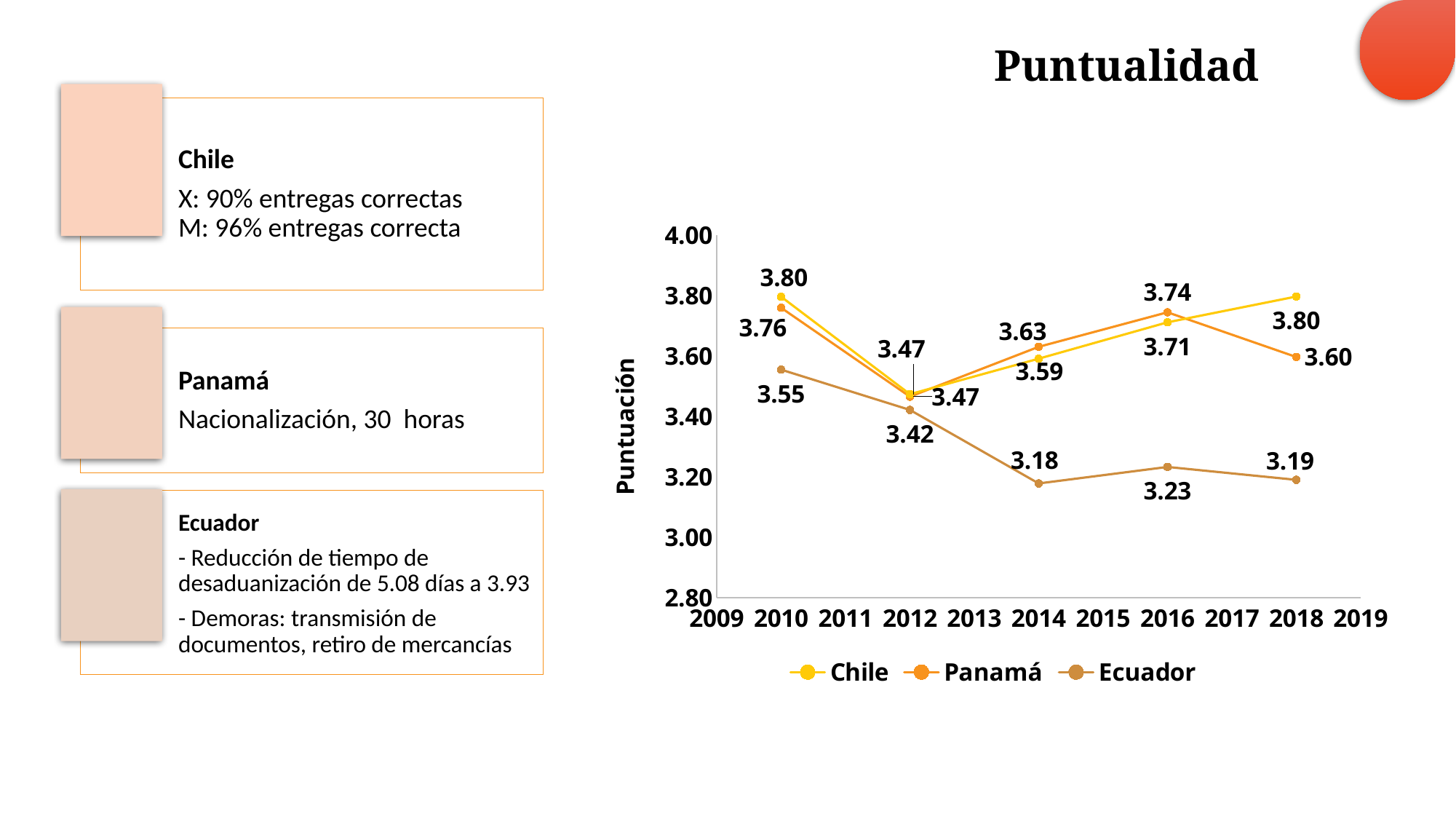
What is the difference between the Chile and Ecuador values in 2018? 0.61 How many series does the legend list? 3 What is the Panamá value in 2018? 3.60 What is the label of the y axis? Puntuación Which series has the higher value in 2014, Chile or Panamá? Panamá What is the Ecuador value in 2014? 3.18 How many data points are plotted for the Ecuador series? 5 What is the Chile value in 2010? 3.80 What is the Chile value in 2016? 3.71 What kind of chart is shown on the slide? Line chart In which year does Ecuador have its lowest value? 2014 In which year does Panamá have its highest value? 2010